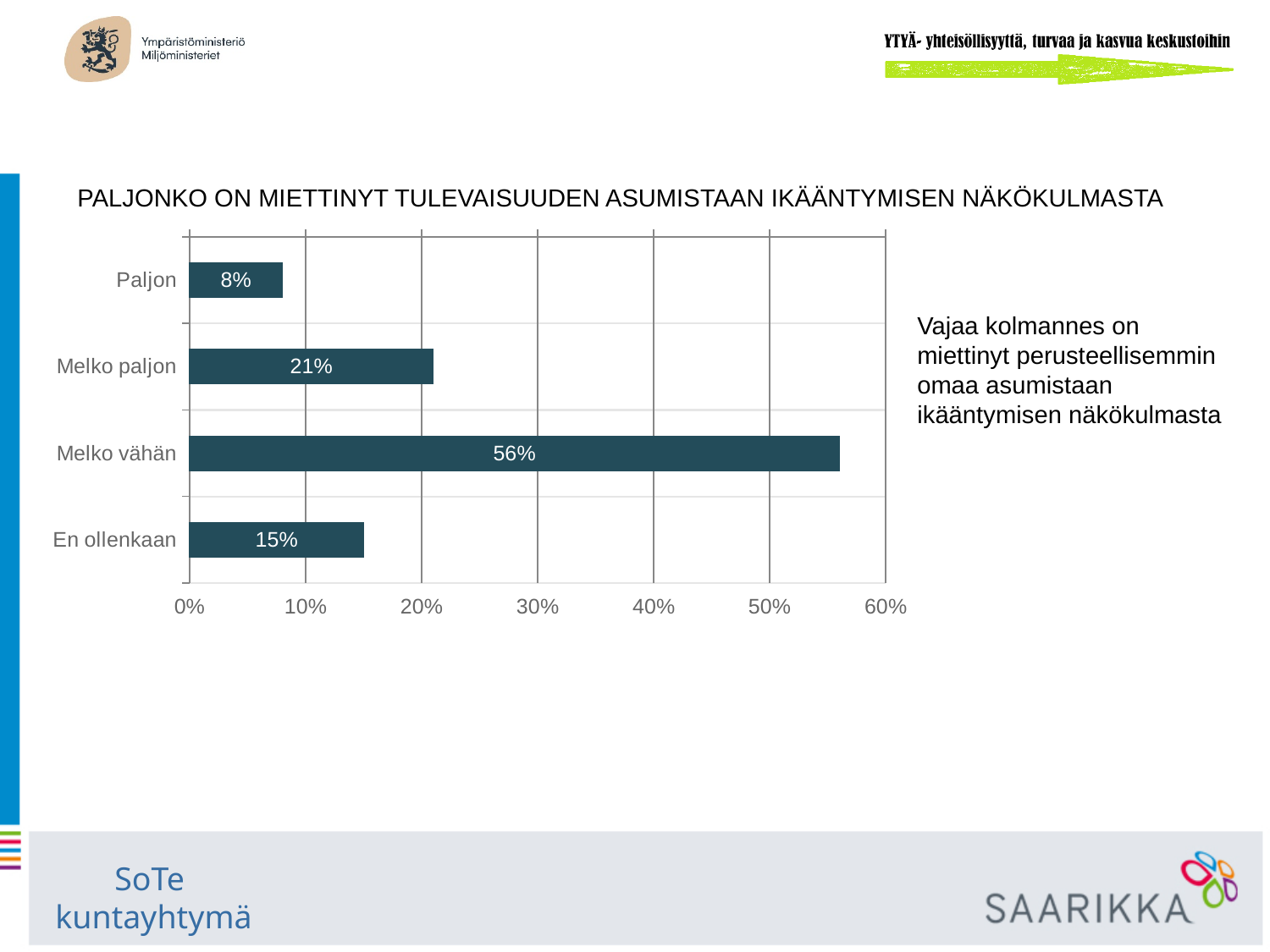
What is the value for Melko vähän? 56% What is the value for Paljon? 8% What is the value for Melko paljon? 21% Which category has the highest value? Melko vähän Which category has the lowest value? Paljon What is the title of the chart? PALJONKO ON MIETTINYT TULEVAISUUDEN ASUMISTAAN IKÄÄNTYMISEN NÄKÖKULMASTA What is the value for En ollenkaan? 15% How many categories are shown in the chart? 4 What kind of chart is shown on the slide? bar chart Which is larger, the value for En ollenkaan or the value for Paljon? En ollenkaan Is the value for Melko vähän greater or less than 50%? greater What is the difference between the values for Melko vähän and Melko paljon? 35%